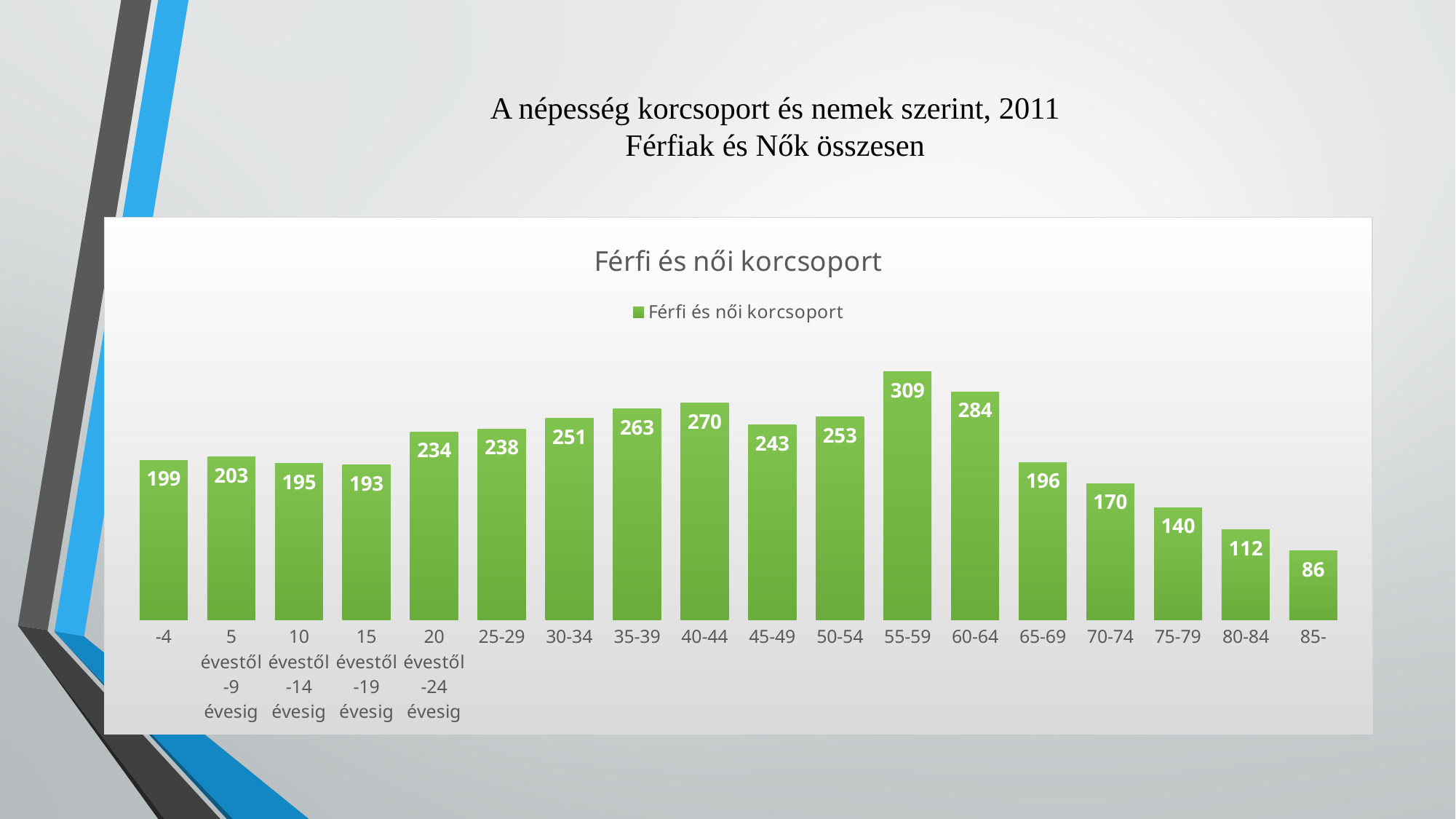
Which age group has the highest value? 55-59 Which age group has the lowest value? 85- What is the value for the 85- age group? 86 What is the difference between the values for 80-84 and 85-? 26 Which is larger, the value for 45-49 or the value for 50-54? 50-54 What kind of chart is shown on the slide? bar chart What is the value for the 40-44 age group? 270 How many series does the legend list? 1 What is the value for the 55-59 age group? 309 How many age groups are shown in the chart? 18 What is the difference between the values for 55-59 and 60-64? 25 What is the title of the chart? Férfi és női korcsoport